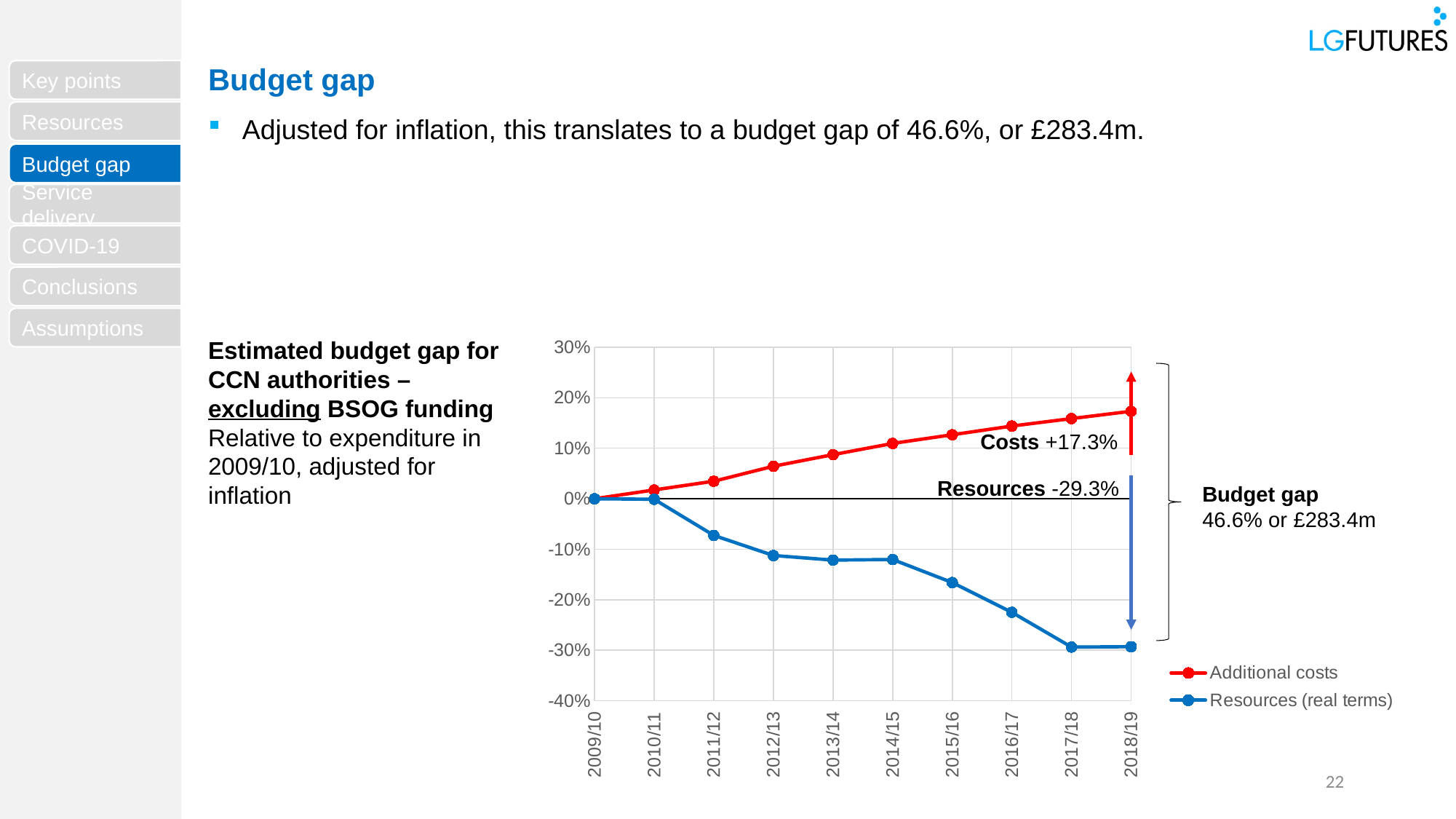
In 2018/19, which series has the larger value: Additional costs or Resources (real terms)? Additional costs Is the value for Additional costs in 2016/17 greater or less than 10%? greater What is the value of Additional costs in 2018/19? +17.3% Do the Additional costs values rise or fall from 2009/10 to 2018/19? rise What is the difference between Additional costs and Resources (real terms) in 2018/19, as shown by the budget gap annotation? 46.6% Do the Resources (real terms) values rise or fall from 2009/10 to 2018/19? fall In which year does Additional costs reach its highest value? 2018/19 What kind of chart is shown on the slide? line chart Is the value for Resources (real terms) in 2016/17 greater or less than -20%? less What is the value of Resources (real terms) in 2018/19? -29.3% How many series does the chart legend list? 2 How many years are plotted along the x axis of the chart? 10